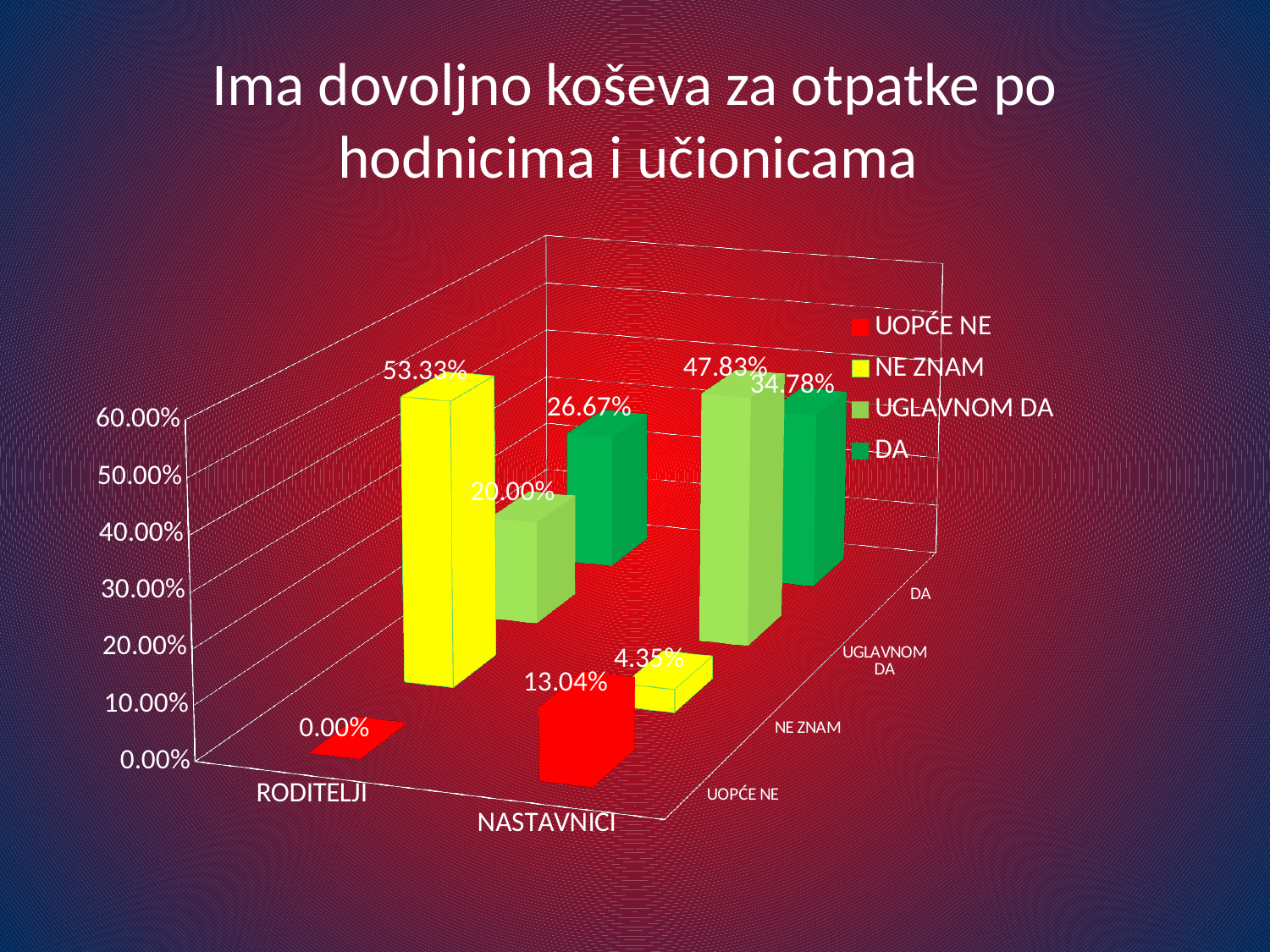
What is the value for NE ZNAM for NASTAVNICI? 4.35% Which series has the highest value for RODITELJI? NE ZNAM What is the value for NE ZNAM for RODITELJI? 53.33% What is the value for DA for RODITELJI? 26.67% Which is larger: UGLAVNOM DA for RODITELJI or UGLAVNOM DA for NASTAVNICI? NASTAVNICI How many series does the legend list? 4 How many categories are shown on the x axis? 2 What is the difference between the DA values for NASTAVNICI and RODITELJI? 8.11% Which series has the lowest value for NASTAVNICI? NE ZNAM What is the value for UGLAVNOM DA for NASTAVNICI? 47.83% What kind of chart is shown on the slide? bar chart What is the value for UOPĆE NE for NASTAVNICI? 13.04%